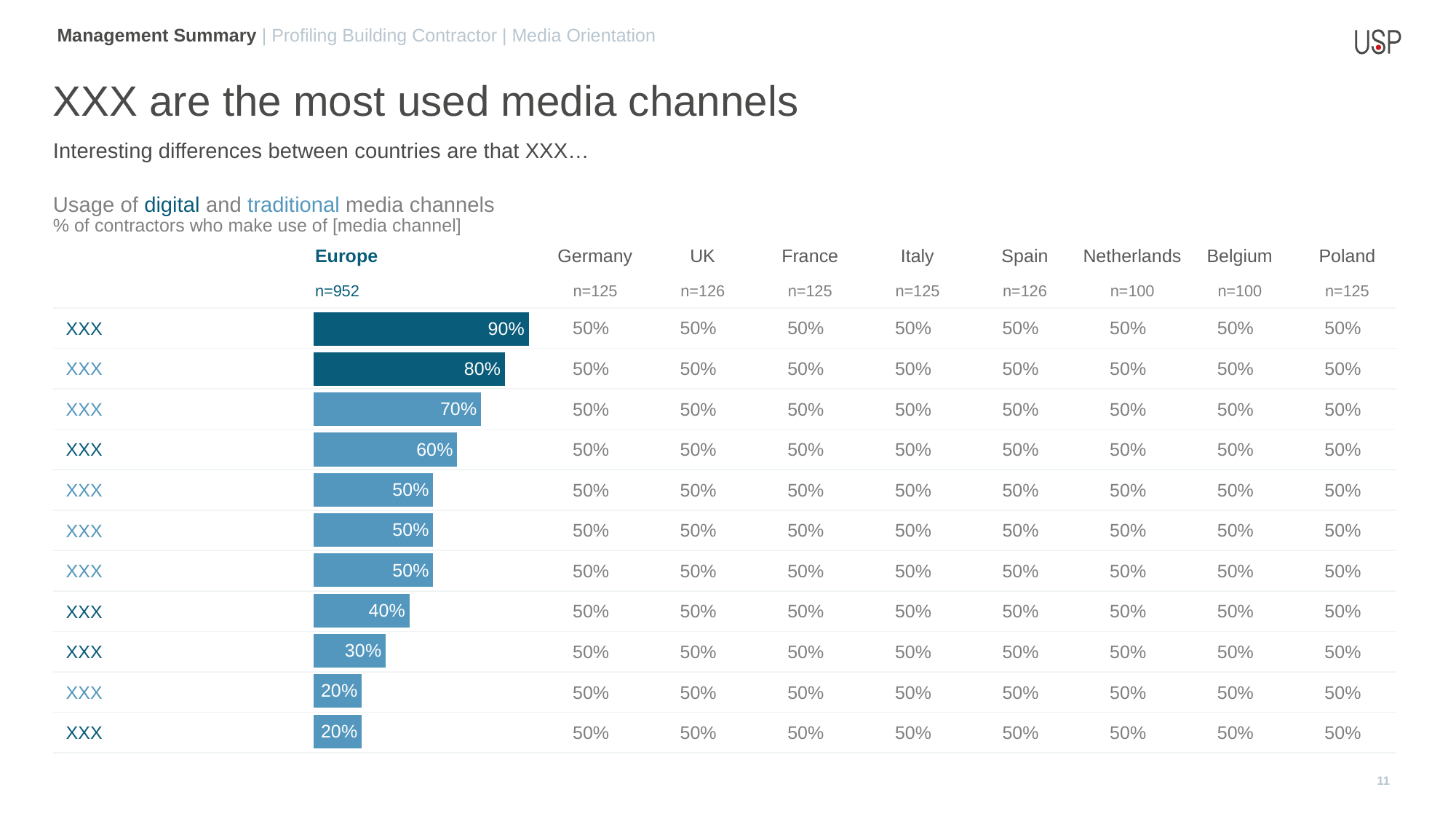
What value is labelled on the fourth bar from the top in the Europe bar chart? 60% How many bars in the Europe bar chart are labelled 50%? 3 What sample size is shown for the Europe column of the chart? n=952 What is the lowest value shown in the Europe bar chart? 20% In the Europe bar chart, which is larger: the second bar from the top or the third bar from the top? the second bar (80%) What is the difference between the top bar (90%) and the bottom bar (20%) in the Europe bar chart? 70 percentage points How many bars are plotted in the Europe bar chart? 11 What value is labelled on the top bar of the Europe bar chart? 90% Do the bar values in the Europe bar chart increase or decrease going from the top bar to the bottom bar? decrease What is the highest value shown in the Europe bar chart? 90% What kind of chart is shown on the slide for the Europe column? bar chart What value is labelled on the bottom bar of the Europe bar chart? 20%